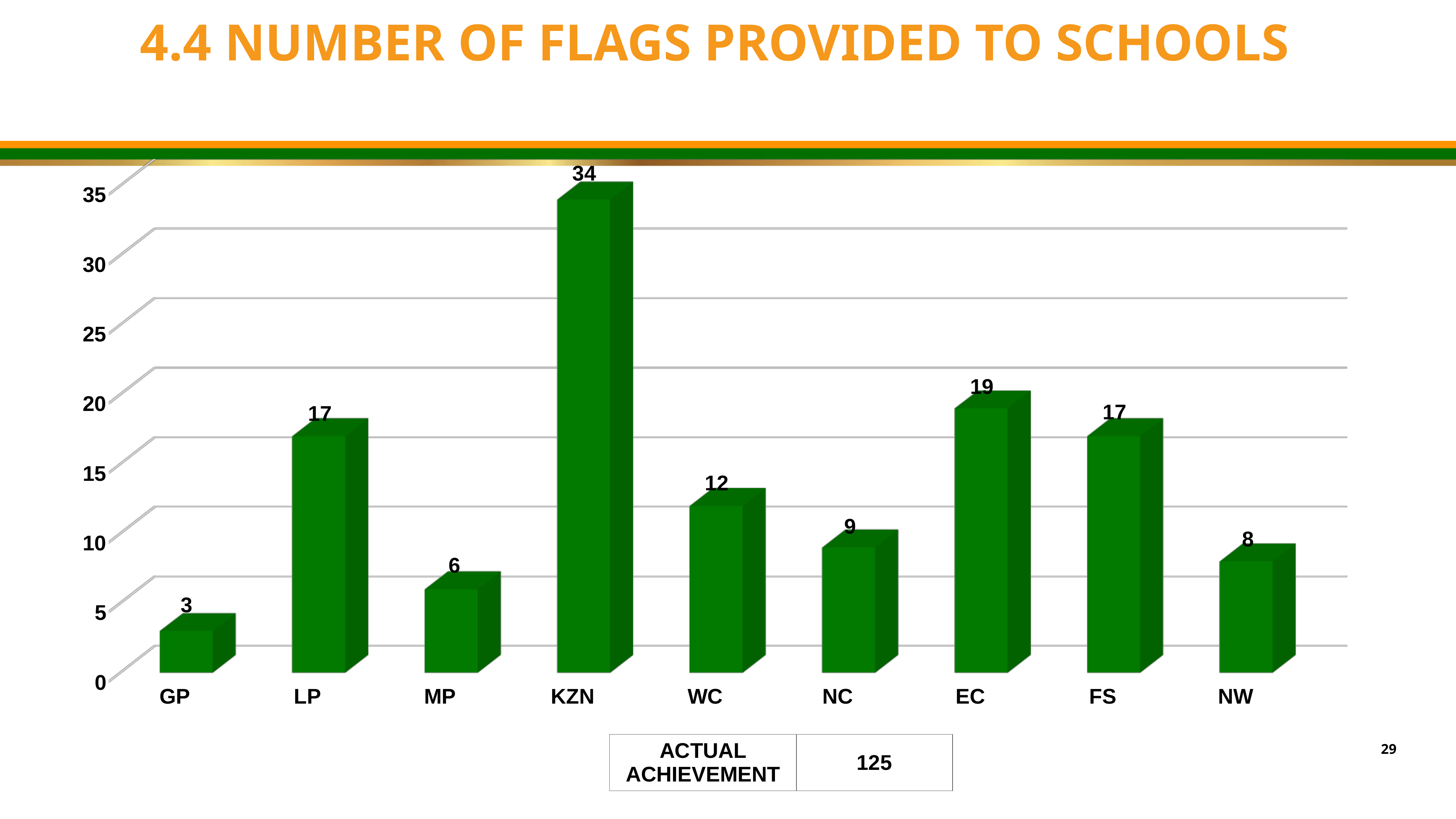
What is the difference between the values for KZN and EC? 15 What is the difference between the values for WC and NC? 3 How many provinces are shown on the x axis of the chart? 9 Is the value for EC greater or less than 15? greater What is the actual achievement total shown in the table below the chart? 125 Which province has the lowest number of flags provided to schools? GP How many flags were provided to schools in KZN? 34 Which province has the highest number of flags provided to schools? KZN What is the value shown for GP? 3 Which is larger, the value for MP or the value for NW? NW What kind of chart is shown on the slide? bar chart What is the value shown for EC? 19